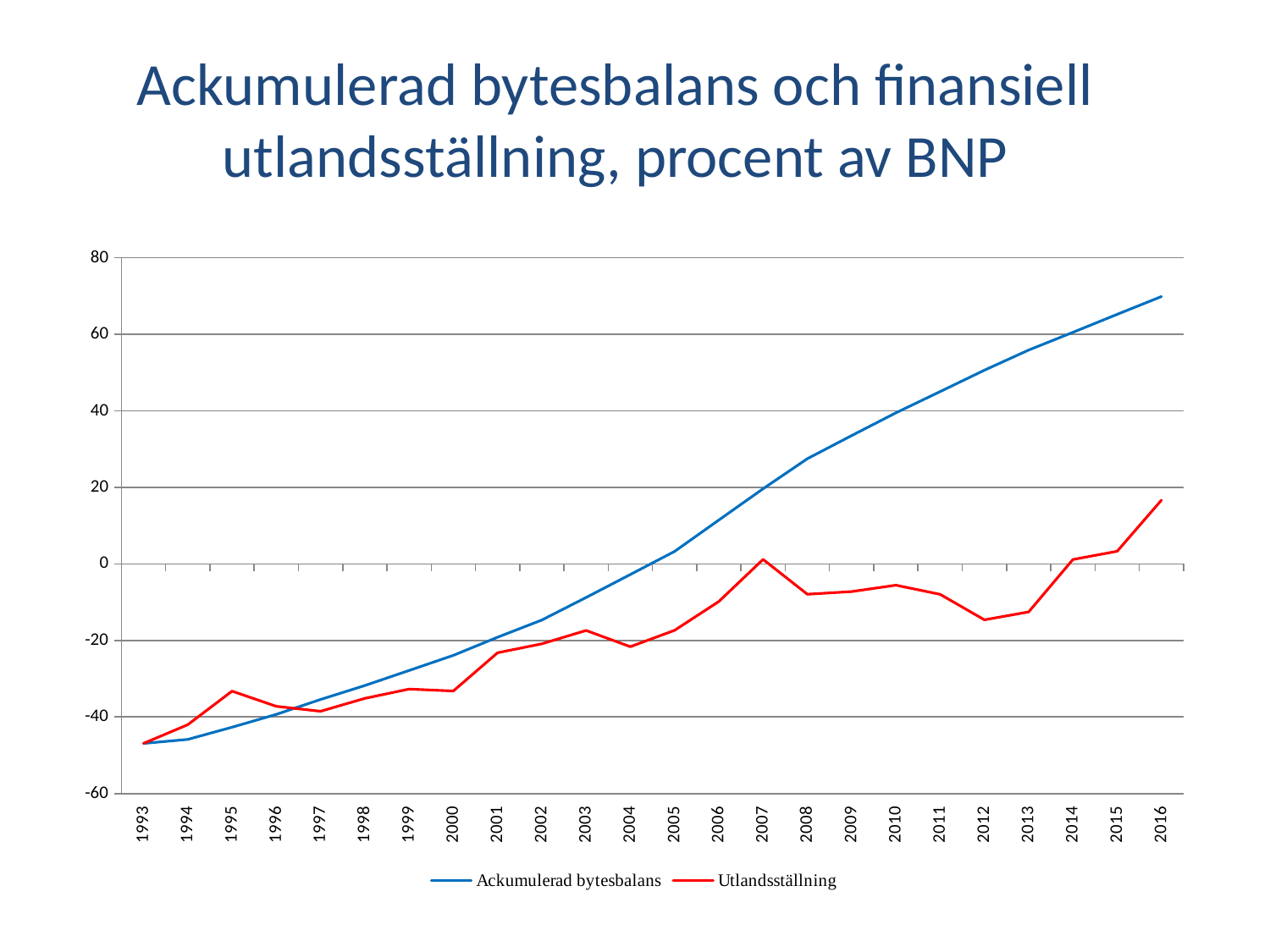
In 1995, which series has the higher value, Ackumulerad bytesbalans or Utlandsställning? Utlandsställning How many series does the legend list? 2 How many years are plotted along the x axis? 24 In which year is Ackumulerad bytesbalans at its highest? 2016 In 2010, which series has the higher value, Ackumulerad bytesbalans or Utlandsställning? Ackumulerad bytesbalans Is the value for Ackumulerad bytesbalans in 1993 greater or less than -40? less Is the value for Ackumulerad bytesbalans in 2016 greater or less than 60? greater Is the value for Utlandsställning in 2007 greater or less than -10? greater In which year is Utlandsställning at its lowest? 1993 Does the Ackumulerad bytesbalans line rise or fall from 1993 to 2016? rise What kind of chart is shown on the slide? line chart